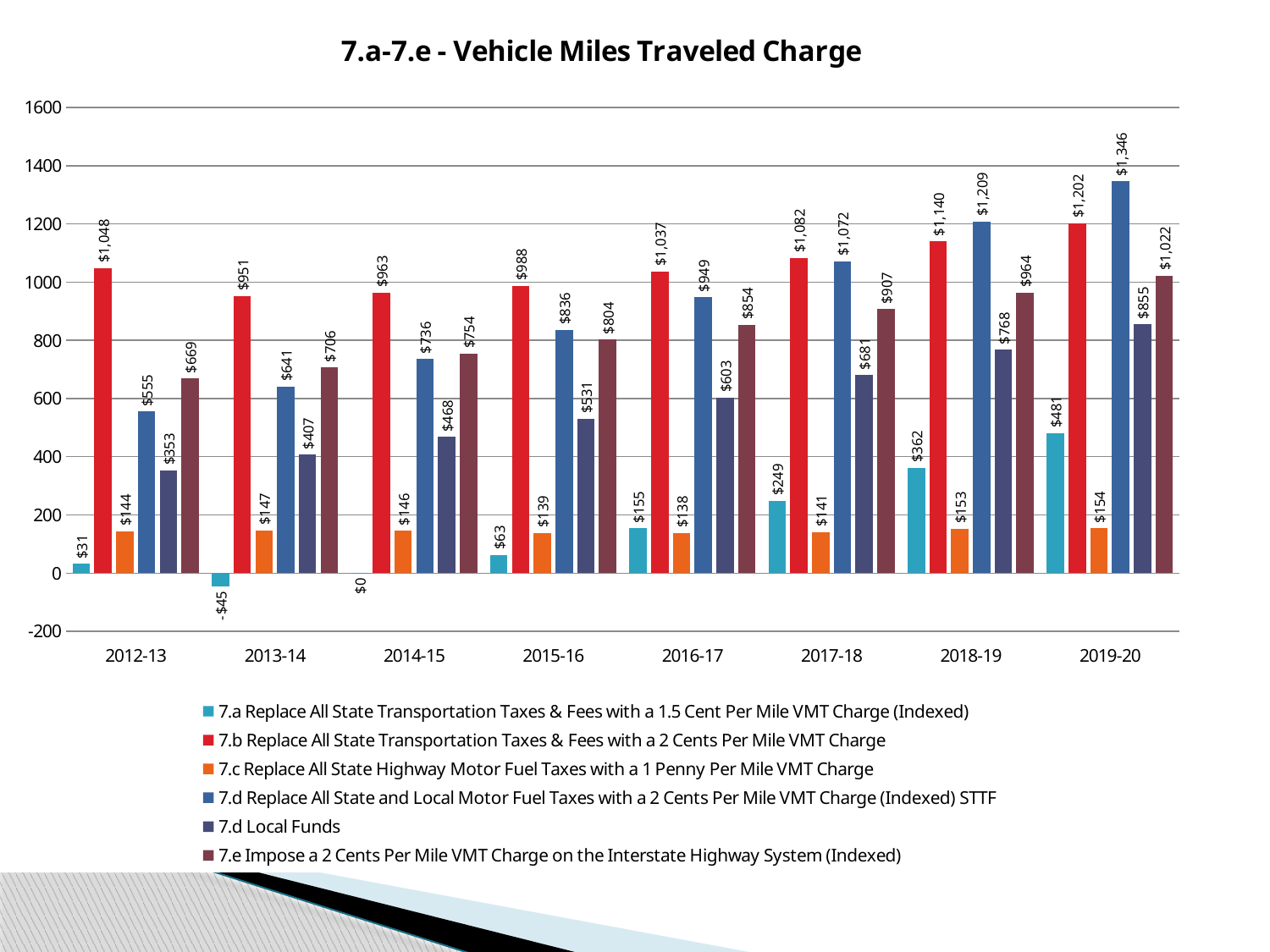
What is the value for 7.d Local Funds in 2016-17? $603 What is the title of the chart? 7.a-7.e - Vehicle Miles Traveled Charge How many series does the legend list? 6 What type of chart is shown on the slide? Bar chart What is the value for 7.a Replace All State Transportation Taxes & Fees with a 1.5 Cent Per Mile VMT Charge (Indexed) in 2013-14? -$45 In 2017-18, which is larger: the 7.b value or the 7.d STTF value? 7.b ($1,082) Does the 7.a Replace All State Transportation Taxes & Fees with a 1.5 Cent Per Mile VMT Charge (Indexed) series rise or fall from 2014-15 to 2019-20? Rise In which year is the 7.e Impose a 2 Cents Per Mile VMT Charge on the Interstate Highway System (Indexed) series lowest? 2012-13 In which year is the 7.d Replace All State and Local Motor Fuel Taxes with a 2 Cents Per Mile VMT Charge (Indexed) STTF series highest? 2019-20 How many fiscal years are shown on the x axis? 8 What is the difference between the 7.d STTF value and the 7.b value in 2019-20? $144 What is the value for 7.b Replace All State Transportation Taxes & Fees with a 2 Cents Per Mile VMT Charge in 2012-13? $1,048